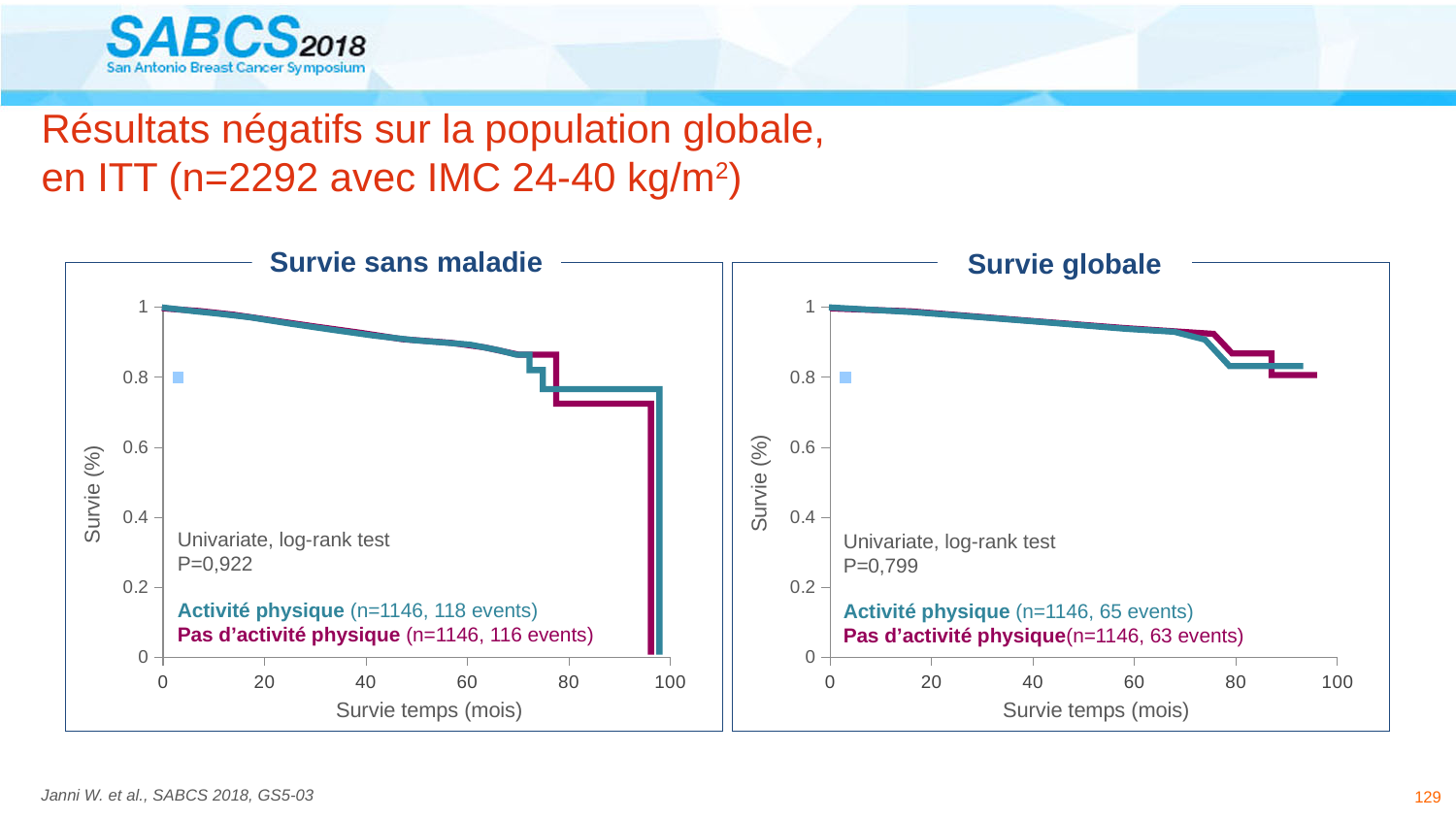
In the 'Survie globale' chart, do the survival values rise or fall as time increases along the x axis? Fall What is the x-axis label of the 'Survie globale' chart? Survie temps (mois) What kind of chart is the 'Survie sans maladie' chart? Line chart What P value is printed on the 'Survie sans maladie' chart? P=0,922 What P value is printed on the 'Survie globale' chart? P=0,799 In the 'Survie globale' chart, is the value for 'Pas d'activité physique' at 60 months greater or less than 0.8? greater In the 'Survie sans maladie' chart, is the value for 'Pas d'activité physique' at 90 months greater or less than 0.8? less In the 'Survie sans maladie' chart, is the value for 'Activité physique' at 40 months greater or less than 0.8? greater In the 'Survie sans maladie' chart, how many events are reported for the 'Activité physique' group? 118 events In the 'Survie globale' chart, how many events are reported for the 'Pas d'activité physique' group? 63 events How many series does the 'Survie globale' chart show? 2 In the 'Survie sans maladie' chart, which group has more events, 'Activité physique' or 'Pas d'activité physique'? Activité physique